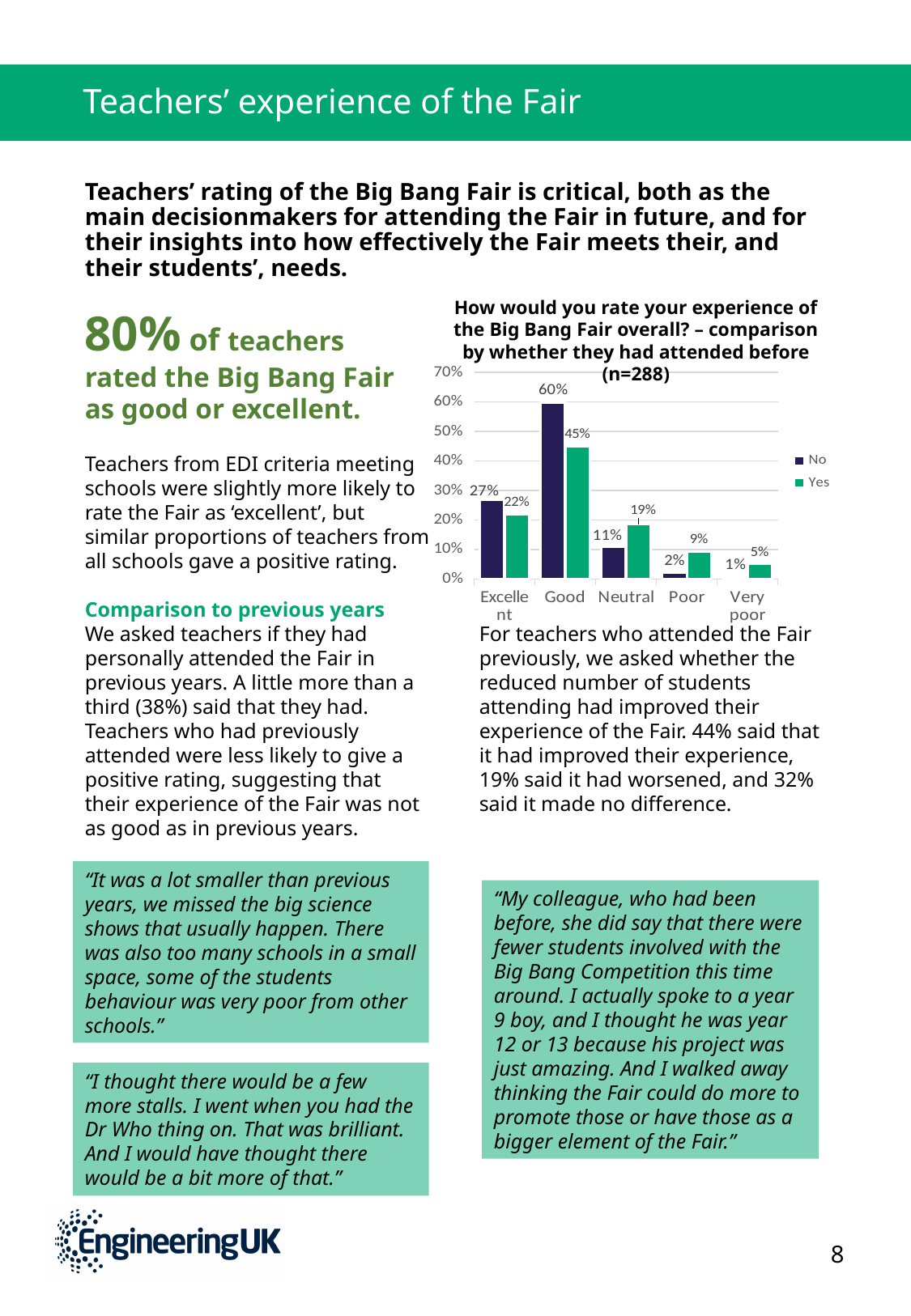
For the Neutral rating, which series has the larger value, No or Yes? Yes What is the sample size (n) stated in the chart title? 288 How many series does the chart legend list? 2 What is the difference between the No and Yes values for the Poor rating? 7% What type of chart is used to show the ratings by whether teachers had attended before? Bar chart How many rating categories are shown on the x axis of the chart? 5 Which rating category has the lowest value for the Yes series? Very poor What percentage of teachers who had attended before (Yes) rated the Fair as Excellent? 22% What percentage of teachers who had attended before (Yes) rated the Fair as Neutral? 19% What is the difference between the No and Yes values for the Good rating? 15% Which rating category has the highest value for the No series? Good What percentage of teachers who had not attended before (No) rated the Fair as Good? 60%